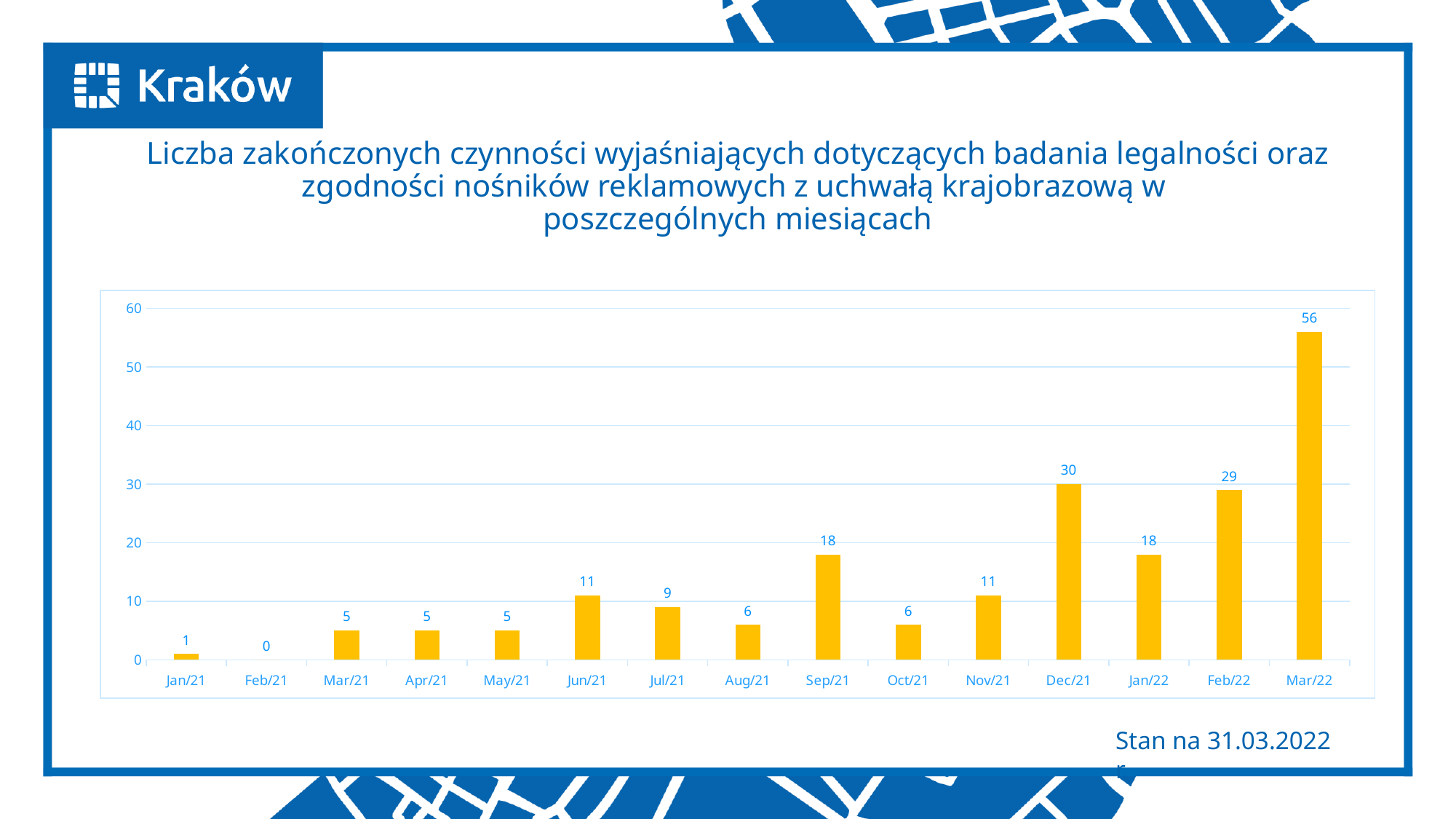
What colour are the bars in the chart? yellow What is the difference between the values for Mar/22 and Feb/22? 27 How many months are shown on the x axis? 15 Is the value for Dec/21 greater or less than 20? greater What is the value for Mar/22? 56 What is the value for Jan/22? 18 What is the value for Dec/21? 30 Which month has the lowest value? Feb/21 Which is larger, the value for Sep/21 or the value for Nov/21? Sep/21 Which month has the highest value? Mar/22 What is the value for Feb/21? 0 What kind of chart is shown on the slide? bar chart